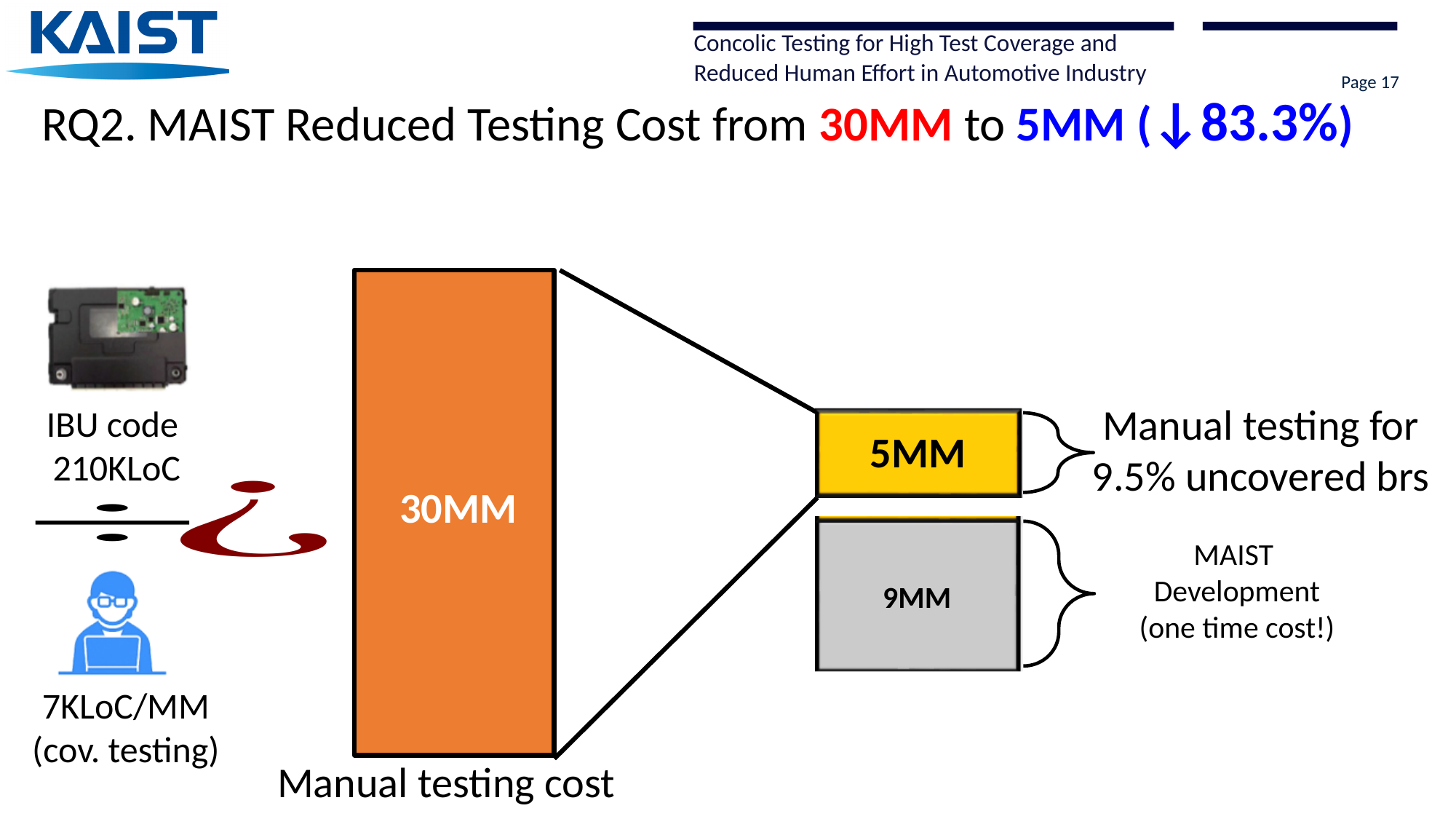
What is the value shown on the large orange bar labelled Manual testing cost? 30MM What is the difference between the MAIST Development cost and the manual testing cost for 9.5% uncovered brs? 4MM Which is larger: the MAIST Development cost or the manual testing cost for 9.5% uncovered brs? MAIST Development (9MM) What colour is the box showing 5MM? Yellow What colour is the bar showing 30MM? Orange Which cost box shows the largest value? Manual testing cost (30MM) What is the value of the box for MAIST Development (one time cost)? 9MM What is the difference between the original manual testing cost (30MM) and the manual testing cost for 9.5% uncovered brs (5MM)? 25MM What is the value of the box for manual testing for 9.5% uncovered brs? 5MM Which cost box shows the smallest value? Manual testing for 9.5% uncovered brs (5MM) What is the combined value of the 5MM and 9MM boxes on the right? 14MM How many cost boxes with values are shown in the diagram? 3